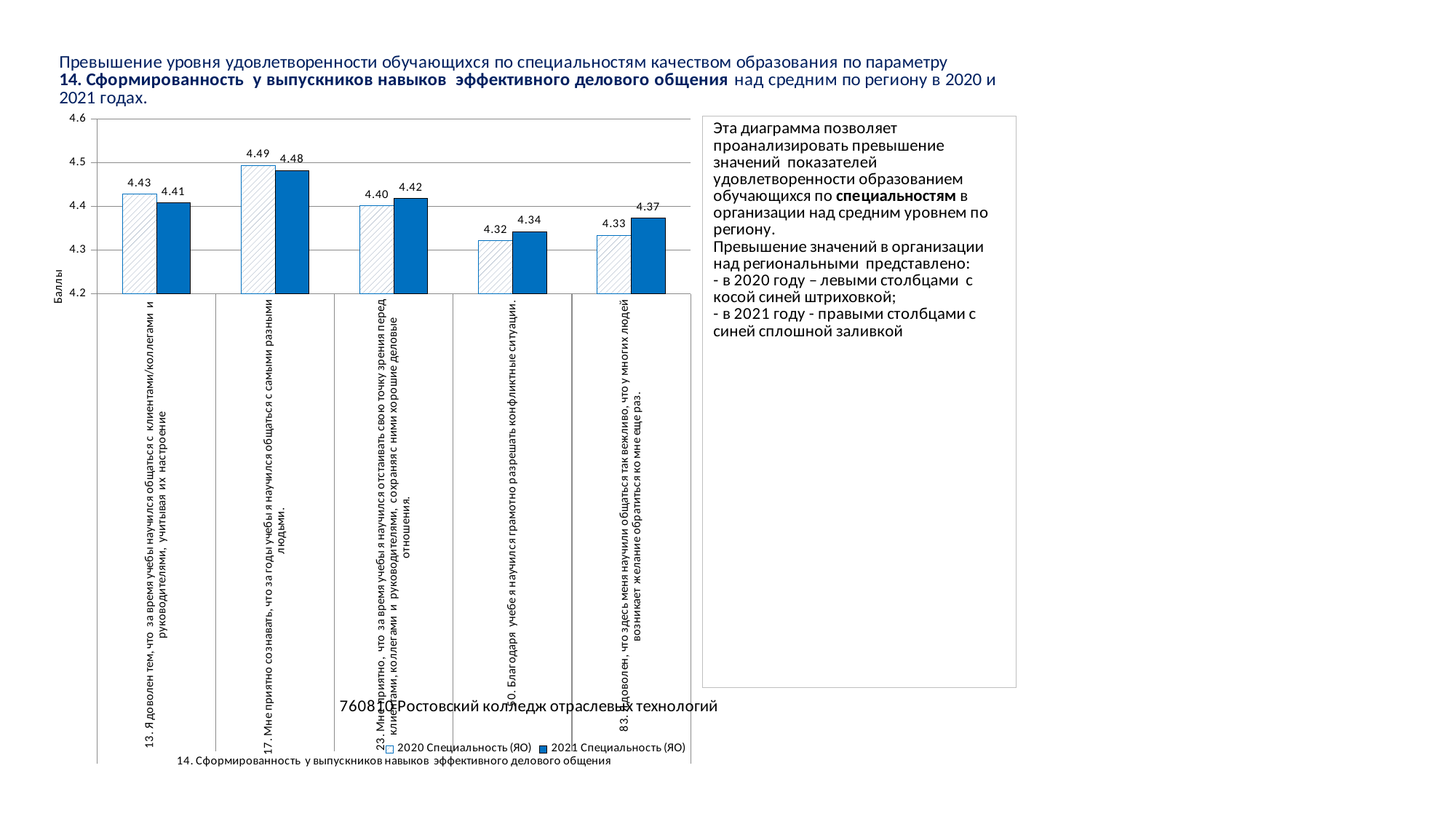
What type of chart is shown on the slide? Bar chart How many statements (categories) are shown on the x axis? 5 How many series does the legend list? 2 For statement 13, which is larger: the 2020 value or the 2021 value? 2020 (4.43) What is the 2020 Специальность (ЯО) value for statement 30 (Благодаря учебе я научился грамотно разрешать конфликтные ситуации)? 4.32 What is the 2020 Специальность (ЯО) value for statement 13 (Я доволен тем, что за время учебы научился общаться с клиентами/коллегами и руководителями)? 4.43 What is the 2021 Специальность (ЯО) value for statement 83? 4.37 Which statement has the highest 2021 Специальность (ЯО) value? 17. Мне приятно сознавать, что за годы учебы я научился общаться с самыми разными людьми What is the difference between the 2021 and 2020 values for statement 83? 0.04 Which statement has the lowest 2020 Специальность (ЯО) value? 50. Благодаря учебе я научился грамотно разрешать конфликтные ситуации What is the 2021 Специальность (ЯО) value for statement 17 (Мне приятно сознавать, что за годы учебы я научился общаться с самыми разными людьми)? 4.48